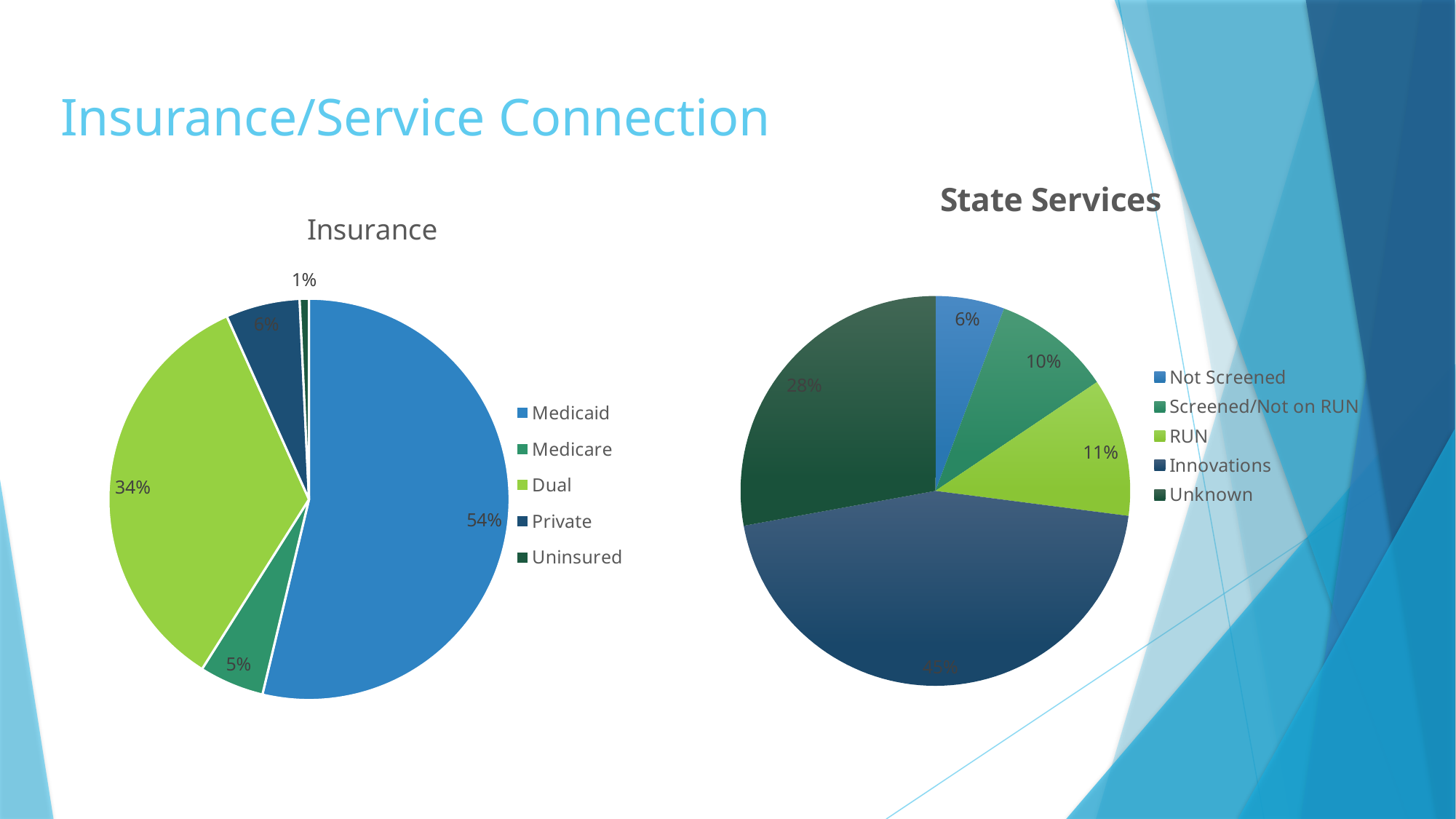
What type of chart is the State Services chart? Pie chart In the State Services chart, what is the difference between the Screened/Not on RUN and Not Screened shares? 4% In the State Services chart, which category has the largest share? Innovations In the State Services chart, what share does RUN have? 11% In the Insurance chart, which category has the smallest share? Uninsured In the Insurance chart, what share does Medicaid have? 54% In the Insurance chart, which is larger, Private or Medicare? Private In the State Services chart, what share does Unknown have? 28% In the Insurance chart, what is the difference between the Medicaid and Dual shares? 20% In the Insurance chart, which category has the largest share? Medicaid How many categories does the Insurance chart's legend list? 5 In the Insurance chart, what share does Dual have? 34%